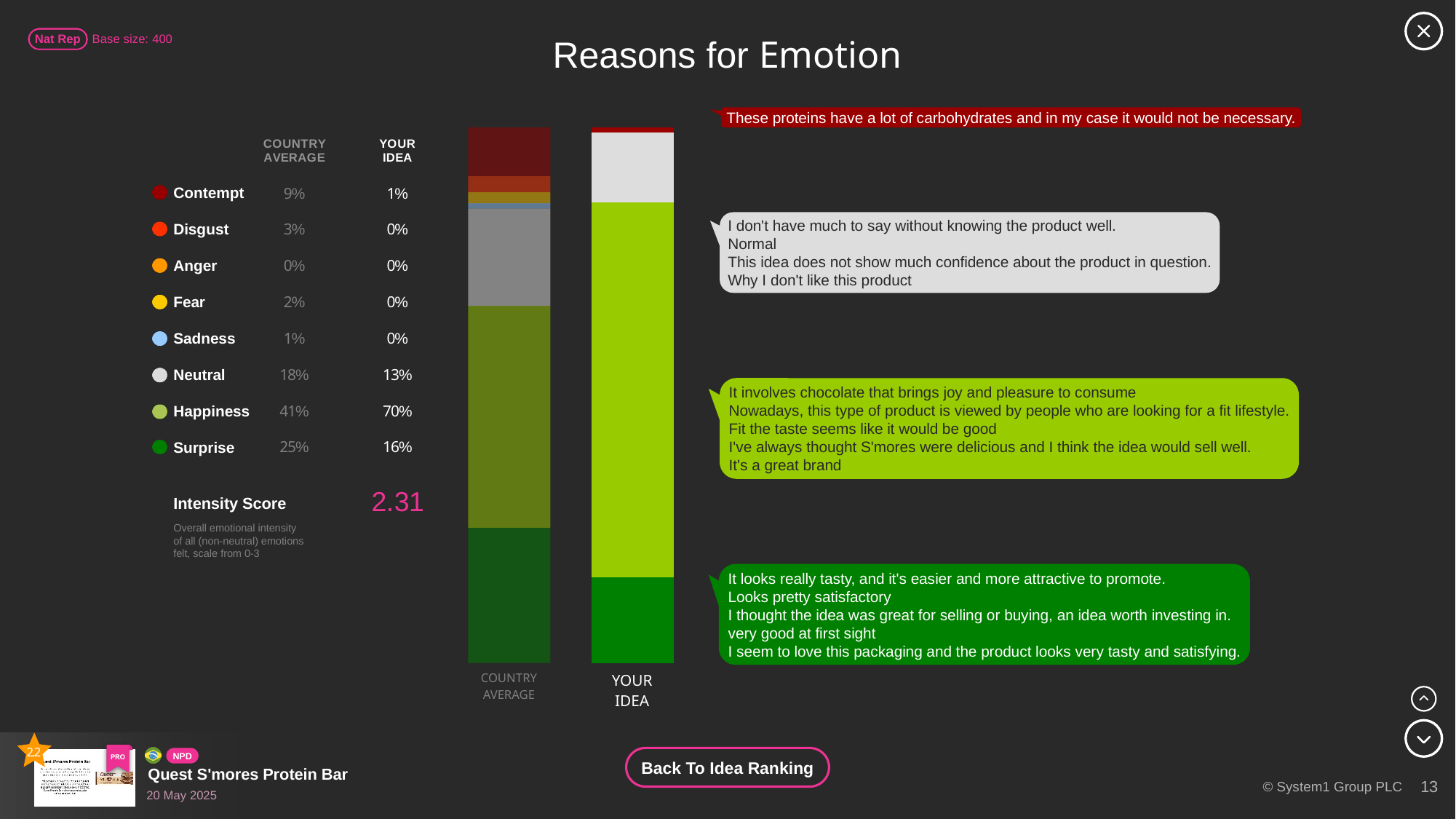
Which emotion has the highest value for the Country Average? Happiness What is the difference between the Country Average and Your Idea values for Neutral? 5 percentage points What is the Happiness value for Your Idea? 70% By how many percentage points does Happiness for Your Idea exceed the Country Average for Happiness? 29 percentage points What is the Country Average value for Neutral? 18% What is the Country Average value for Surprise? 25% What is the Intensity Score shown on the slide? 2.31 What is the Contempt value for Your Idea? 1% Is the Surprise value larger for the Country Average or for Your Idea? Country Average How many emotions are listed in the chart? 8 What kind of chart is shown on the slide? Stacked bar chart Which emotion has the highest value for Your Idea? Happiness